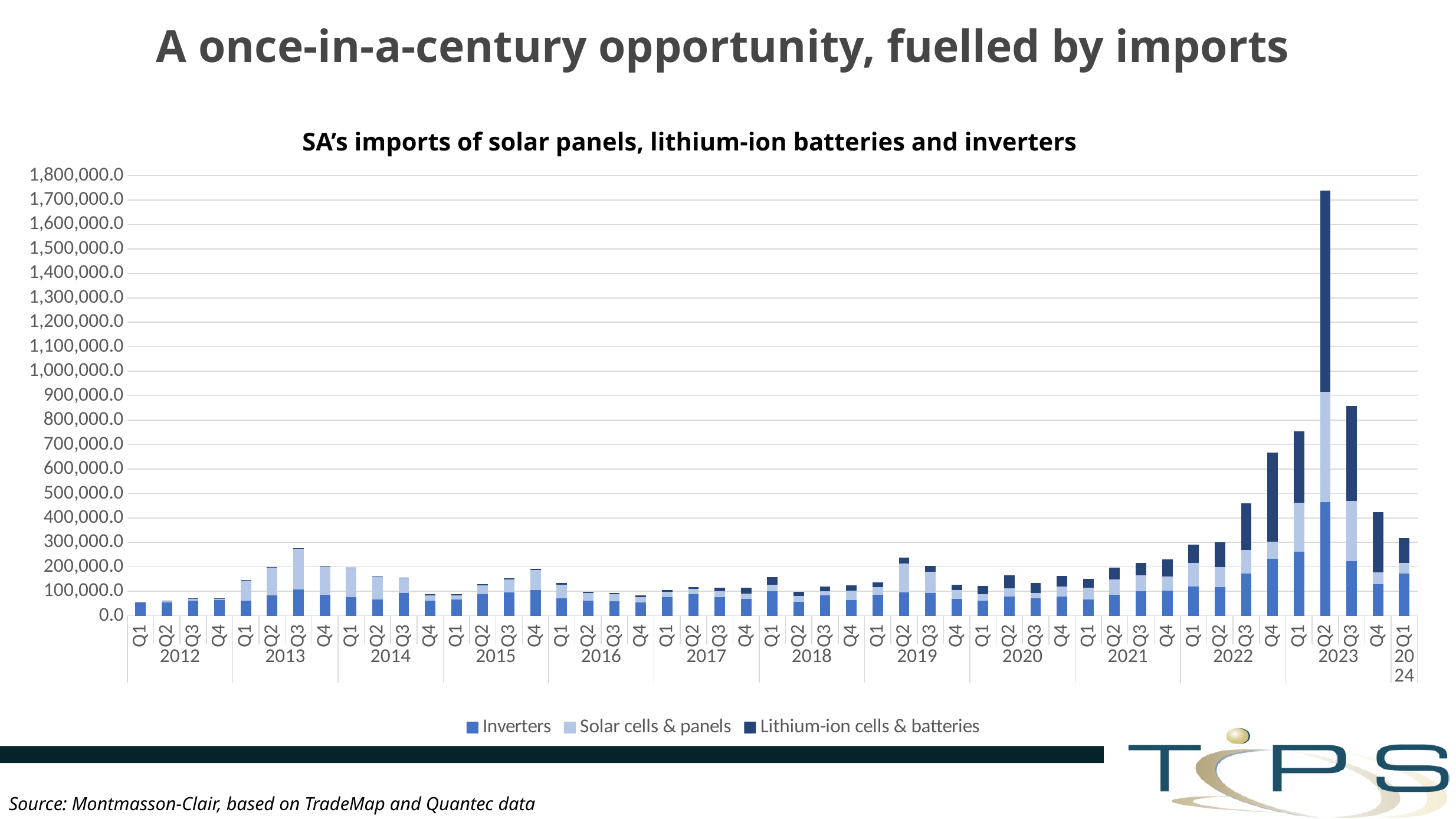
Which quarter has the highest total imports? Q2 2023 Is the total for Q1 2024 greater or less than 400,000.0? less Is the total for Q3 2023 greater or less than 800,000.0? greater Do total imports rise or fall from Q1 2021 to Q2 2023? Rise How many series does the legend list? 3 What kind of chart is shown on the slide? Stacked bar chart Which has the larger total imports, Q4 2023 or Q1 2024? Q4 2023 Is the total for Q1 2012 greater or less than 100,000.0? less What is the title of the chart? SA's imports of solar panels, lithium-ion batteries and inverters Which has the larger total imports, Q3 2013 or Q1 2014? Q3 2013 What are the three series listed in the legend? Inverters, Solar cells & panels, Lithium-ion cells & batteries